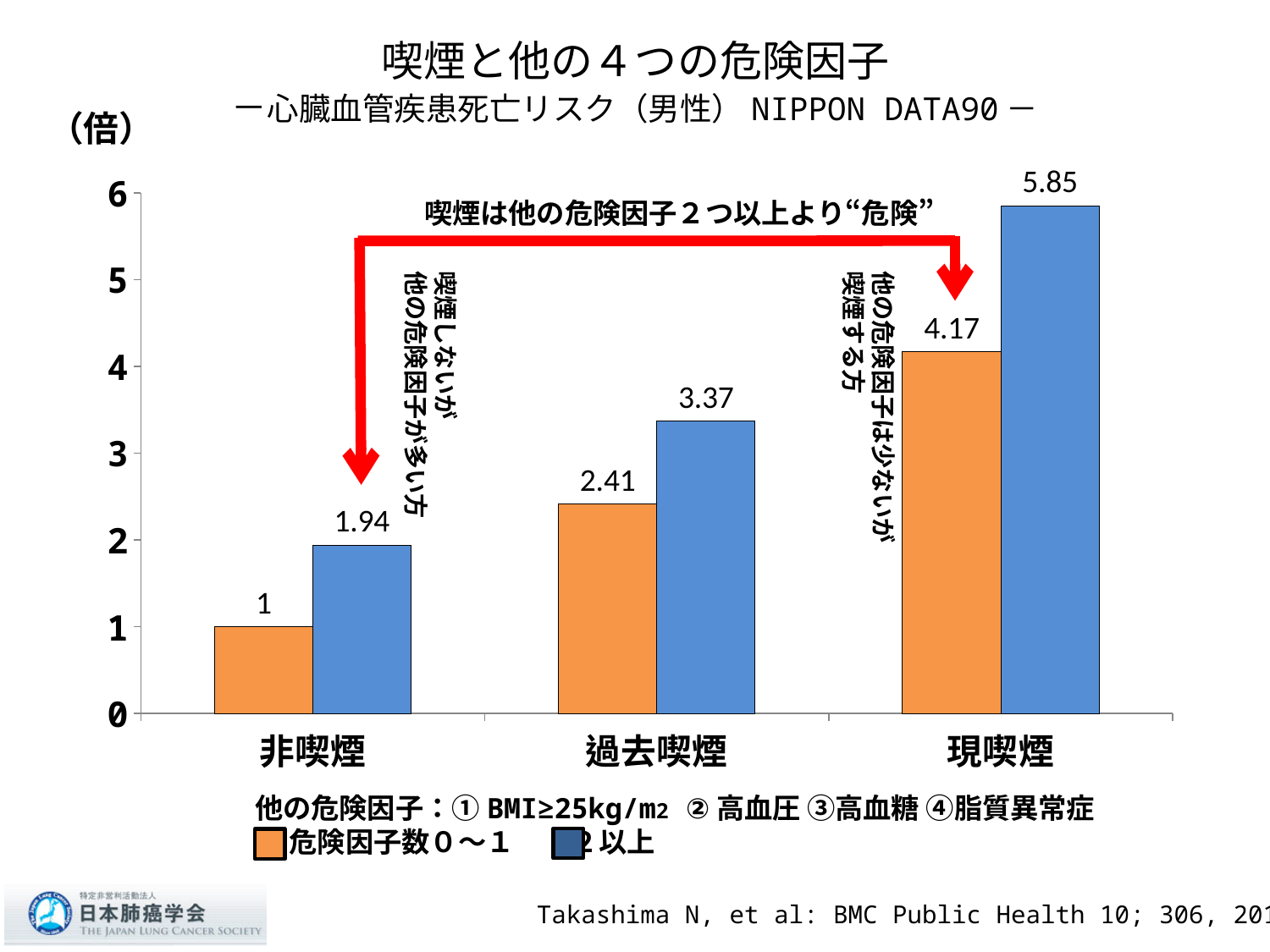
What is the value for 過去喫煙 in the 2以上 series? 3.37 Do the values in the 2以上 series rise or fall from 非喫煙 to 現喫煙? Rise What is the value for 非喫煙 in the 2以上 series? 1.94 What is the difference between the 危険因子数0〜1 values for 現喫煙 and 過去喫煙? 1.76 What is the value for 現喫煙 in the 危険因子数0〜1 series? 4.17 How many categories are shown on the x axis? 3 Which is larger: the 危険因子数0〜1 value for 現喫煙 or the 2以上 value for 過去喫煙? 危険因子数0〜1 value for 現喫煙 What is the difference between the 2以上 and 危険因子数0〜1 values for 現喫煙? 1.68 Which category has the lowest value in the 危険因子数0〜1 series? 非喫煙 How many series does the legend list? 2 What kind of chart is shown on the slide? Bar chart Which category has the highest value in the 2以上 series? 現喫煙